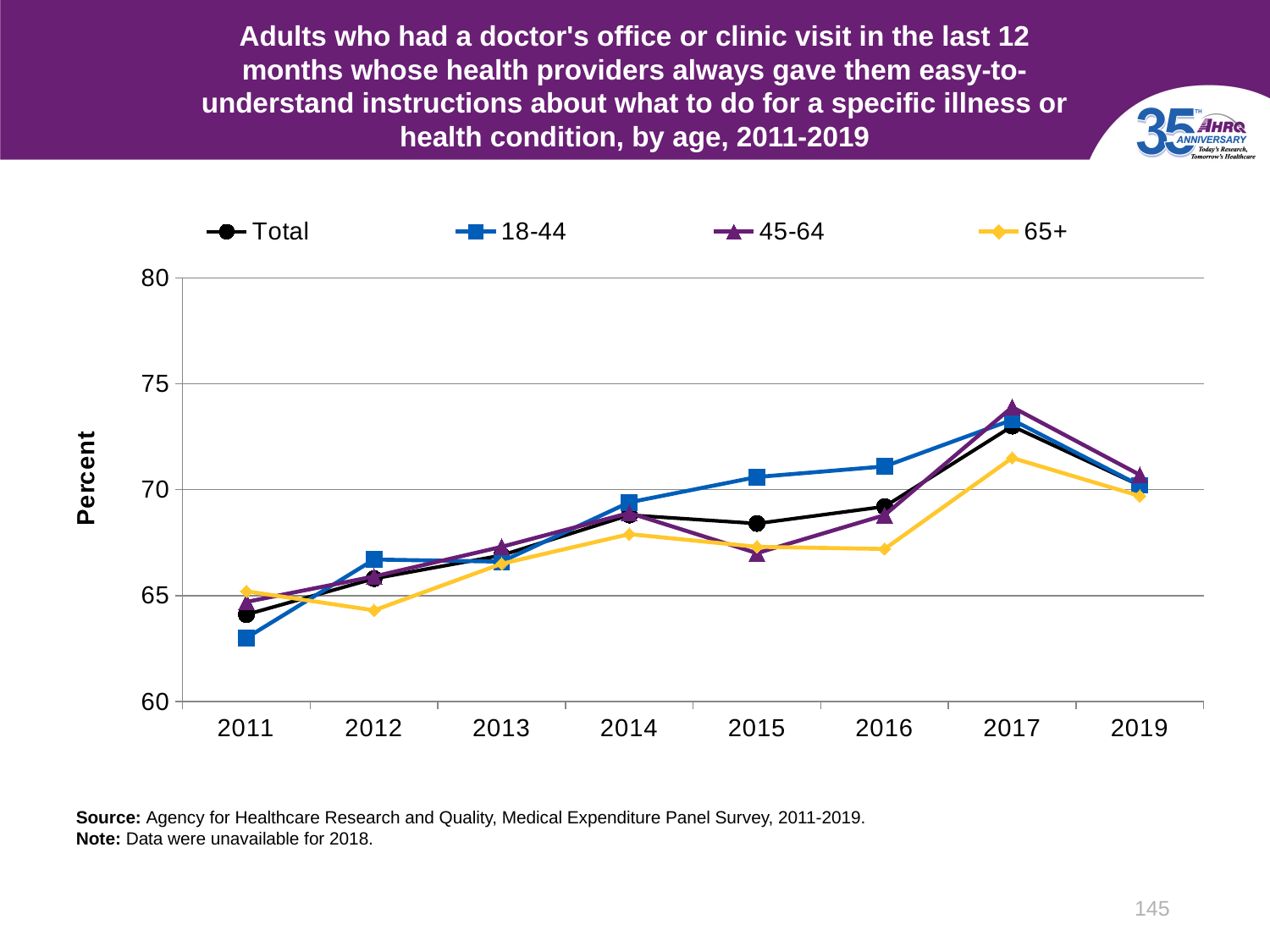
What is the label on the y axis? Percent Does the Total series rise or fall from 2011 to 2017? rise Is the value for 65+ in 2012 greater or less than 65? less In 2015, which is larger: the value for 18-44 or the value for 45-64? 18-44 Is the value for 45-64 in 2017 greater or less than 70? greater How many years are plotted along the x axis? 8 How many series does the legend list? 4 In which year is the 18-44 series at its highest? 2017 In which year is the 18-44 series at its lowest? 2011 In 2011, which is larger: the value for 18-44 or the value for 65+? 65+ What kind of chart is shown on the slide? line chart Is the value for 18-44 in 2011 greater or less than 65? less